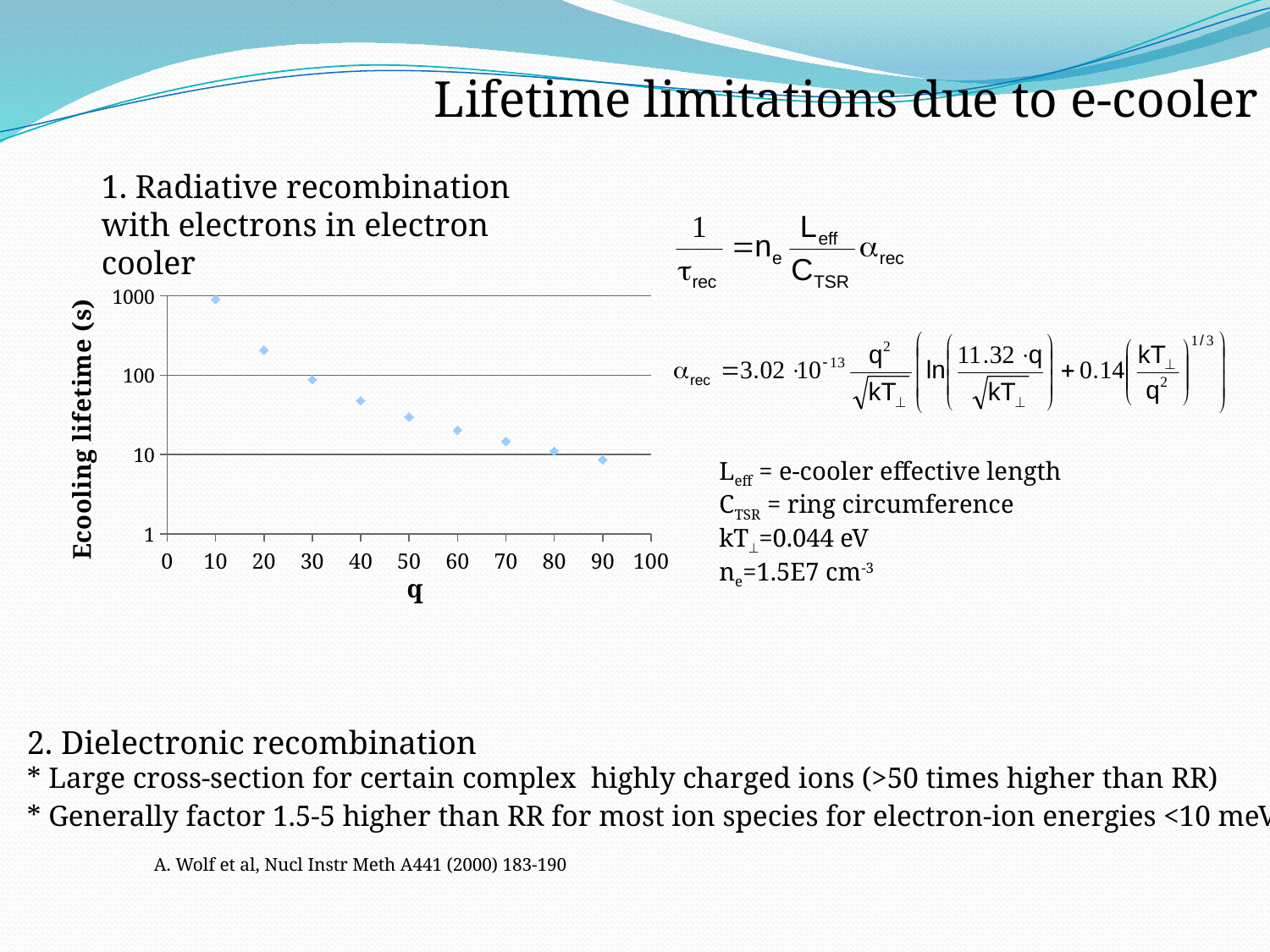
Is the e-cooling lifetime at q = 60 greater or less than 10? greater Is the e-cooling lifetime at q = 40 greater or less than 100? less At which value of q is the e-cooling lifetime lowest? 90 What is the label of the chart's y axis? Ecooling lifetime (s) Is the e-cooling lifetime at q = 20 greater or less than 100? greater At which value of q is the e-cooling lifetime highest? 10 How many data points are plotted in the chart? 9 Which has the larger e-cooling lifetime, q = 20 or q = 70? q = 20 Does the e-cooling lifetime rise or fall as q increases along the x axis? fall What kind of chart is shown on the slide? scatter chart